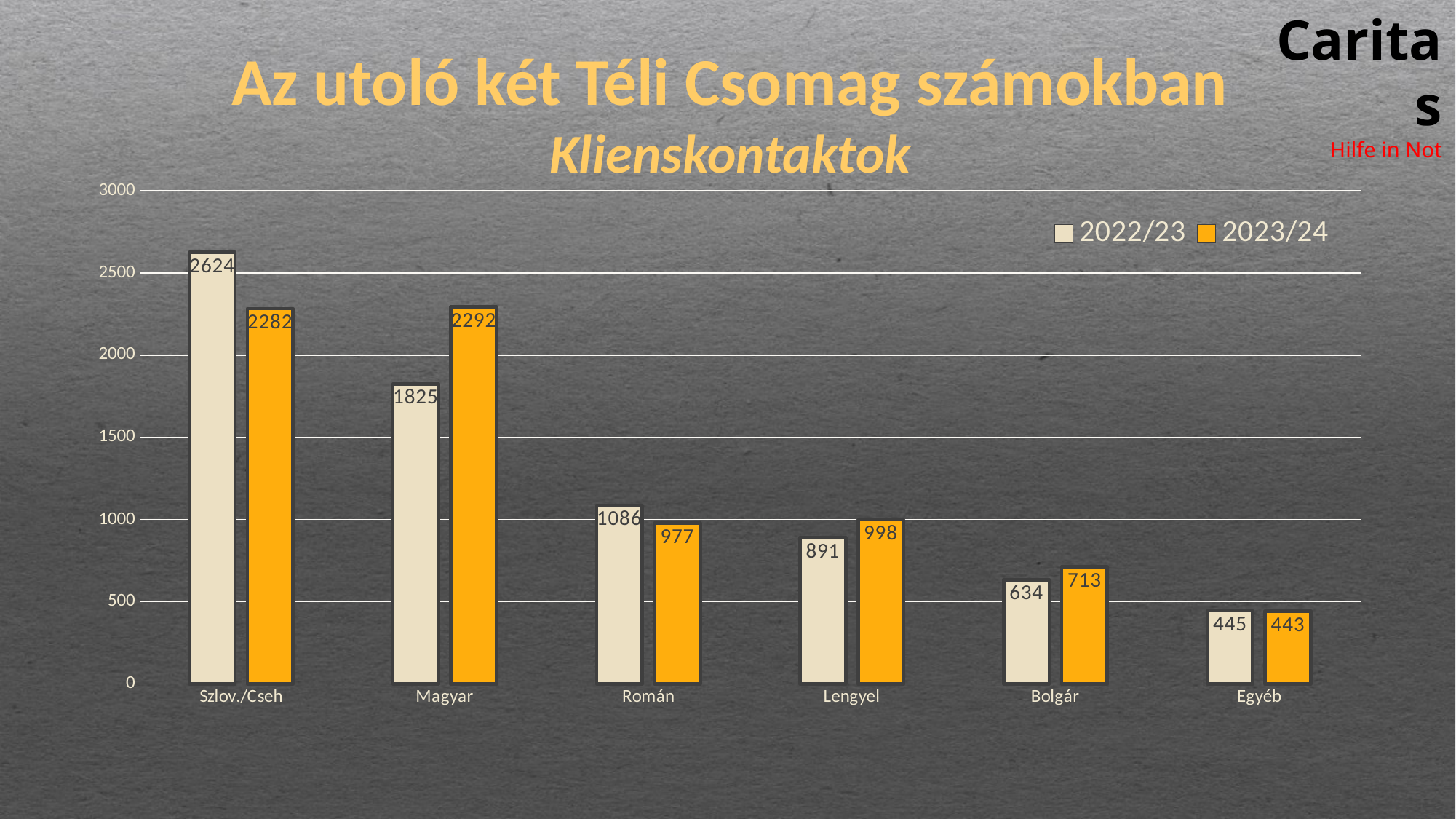
Is the 2022/23 value for Bolgár greater or less than 500? greater What is the 2023/24 value for Magyar? 2292 Which category has the highest 2022/23 value? Szlov./Cseh How many categories are shown on the x axis? 6 Which is larger for Román: the 2022/23 value or the 2023/24 value? 2022/23 What kind of chart is shown on the slide? bar chart What is the difference between the 2022/23 and 2023/24 values for Szlov./Cseh? 342 What is the 2023/24 value for Lengyel? 998 How many series does the legend list? 2 Which category has the lowest 2023/24 value? Egyéb What is the 2022/23 value for Szlov./Cseh? 2624 What is the difference between the 2023/24 and 2022/23 values for Magyar? 467